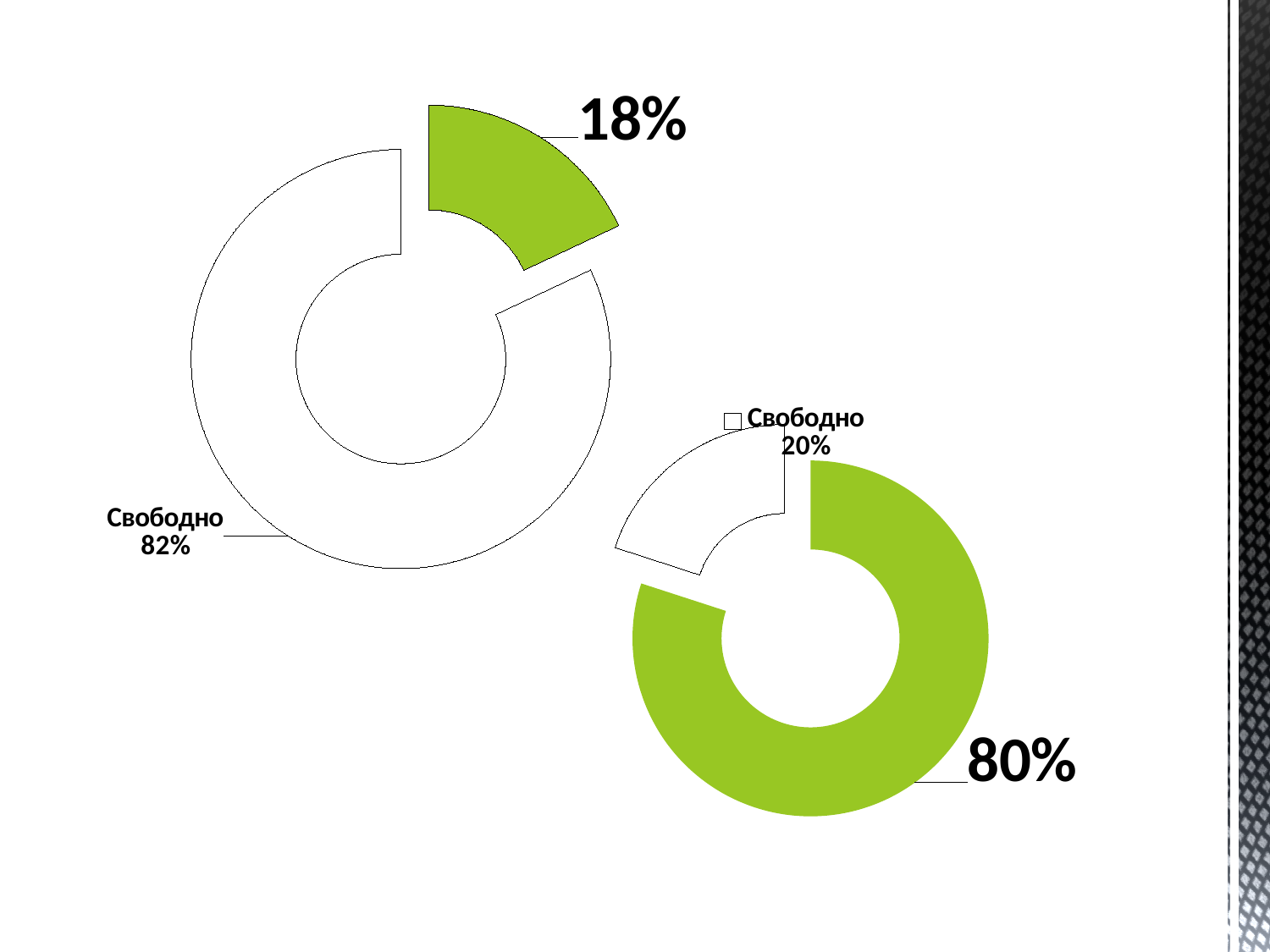
On the lower-right chart, what is the difference between the green slice and the "Свободно" share? 60% How many slices does the lower-right chart have? 2 On the lower-right chart, which slice is larger, the green slice or "Свободно"? The green slice How many charts are shown on the slide? 2 On the lower-right chart, what share is labelled "Свободно"? 20% On the upper-left chart, what is the difference between the "Свободно" share and the green slice? 64% What kind of chart is the upper-left chart? Doughnut chart On the upper-left chart, which slice is larger, the green slice or "Свободно"? Свободно On the upper-left chart, what share is labelled "Свободно"? 82% On the lower-right chart, what value is shown for the green slice? 80% How many slices does the upper-left chart have? 2 On the upper-left chart, what value is shown for the green slice? 18%